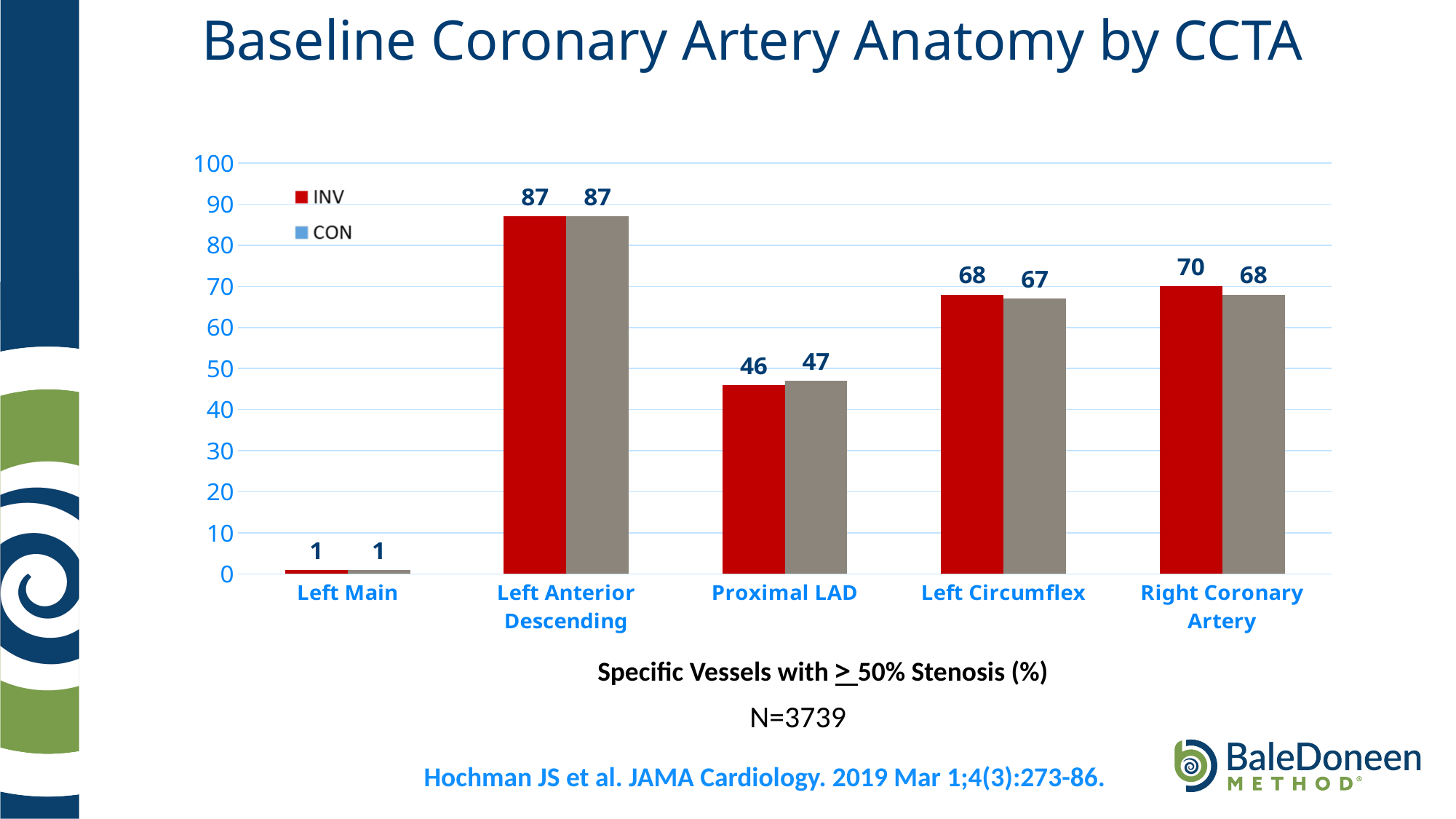
What is the CON value for Proximal LAD? 47 Which is larger: the INV value for Left Circumflex or the INV value for Proximal LAD? Left Circumflex What is the INV value for Left Anterior Descending? 87 What is the difference between the INV values for Left Anterior Descending and Proximal LAD? 41 What is the title of the slide? Baseline Coronary Artery Anatomy by CCTA What is the INV value for Right Coronary Artery? 70 Which vessel has the highest INV value? Left Anterior Descending What kind of chart is shown on the slide? Bar chart Which vessel has the lowest CON value? Left Main How many vessel categories are shown on the x axis? 5 How many series does the legend list? 2 What is the CON value for Left Circumflex? 67